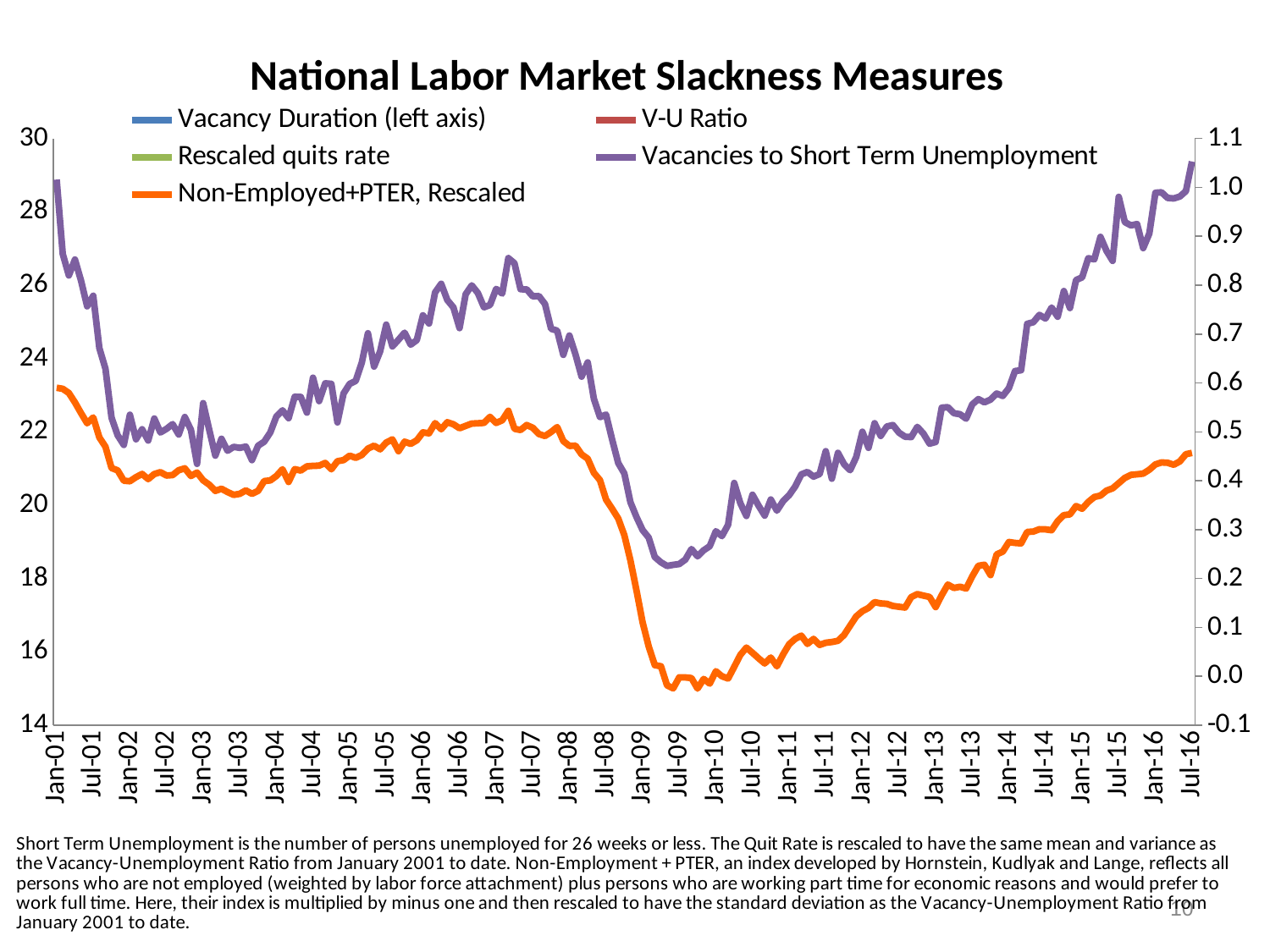
What kind of chart is shown on the slide? line chart Is the Non-Employed+PTER, Rescaled line higher at Jan-01 or at Jul-09? Jan-01 Is the value of the Non-Employed+PTER, Rescaled line at Jul-09 greater or less than 16 on the left axis? less What colour is the Non-Employed+PTER, Rescaled line? orange Is the value of the Vacancies to Short Term Unemployment line at Jul-16 greater or less than 1.0 on the right axis? greater Is the value of the Vacancies to Short Term Unemployment line at Jul-09 greater or less than 0.3 on the right axis? less What is the title of the chart? National Labor Market Slackness Measures Does the Non-Employed+PTER, Rescaled line rise or fall between Jan-08 and Jan-09? fall Does the Vacancies to Short Term Unemployment line rise or fall between Jul-09 and Jul-16? rise How many series does the legend list? 5